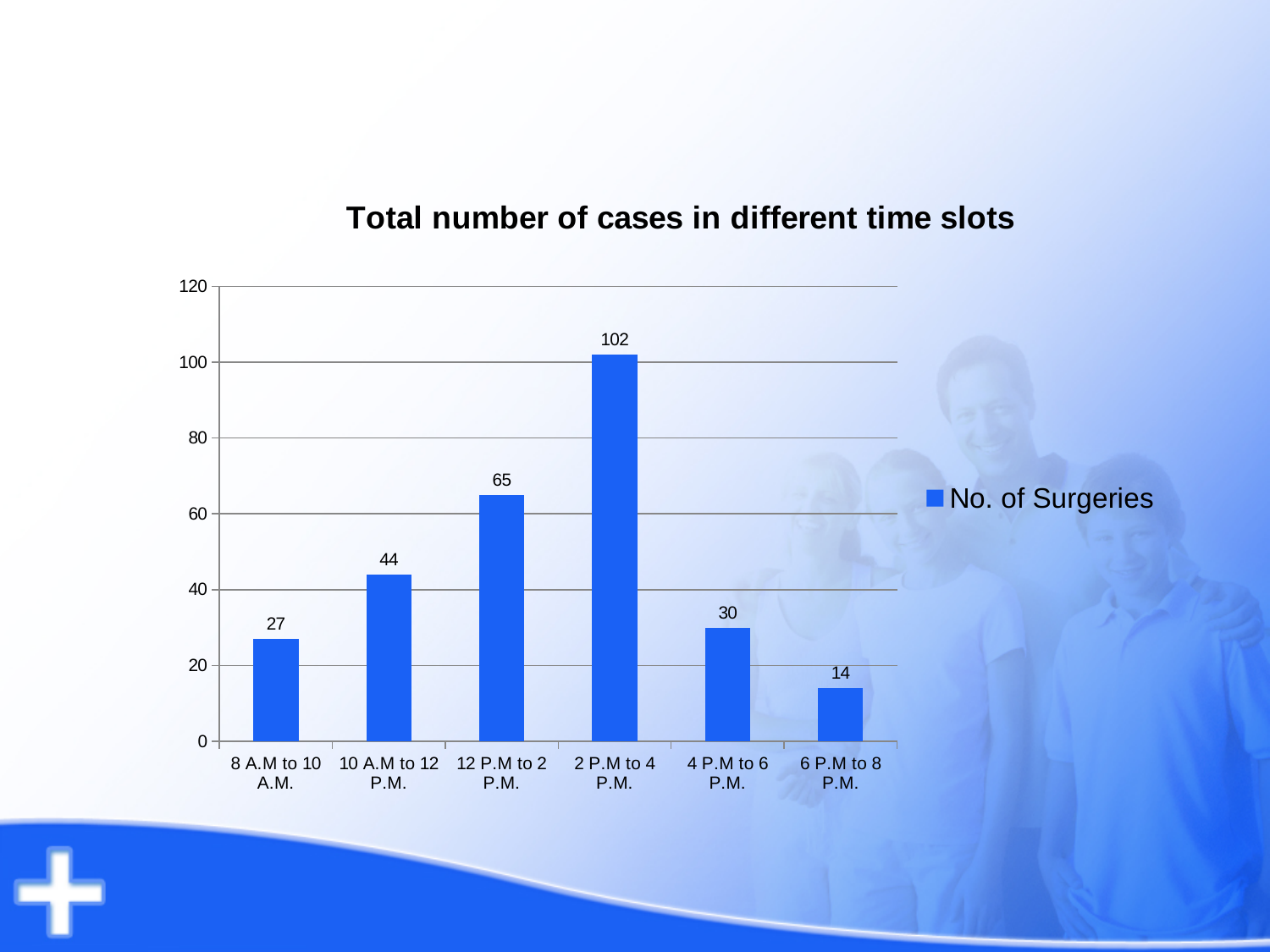
How many series does the legend list? 1 What is the number of surgeries in the 2 P.M to 4 P.M. time slot? 102 Which time slot has the lowest number of surgeries? 6 P.M to 8 P.M. What is the number of surgeries in the 8 A.M to 10 A.M. time slot? 27 Which time slot has more surgeries, 10 A.M to 12 P.M. or 4 P.M to 6 P.M.? 10 A.M to 12 P.M. What is the number of surgeries in the 6 P.M to 8 P.M. time slot? 14 Which time slot has the highest number of surgeries? 2 P.M to 4 P.M. What is the difference in the number of surgeries between the 2 P.M to 4 P.M. slot and the 12 P.M to 2 P.M. slot? 37 Is the value for 12 P.M to 2 P.M. greater or less than 60? greater What kind of chart is shown on the slide? Bar chart What is the title of the chart? Total number of cases in different time slots How many time slots are shown on the chart? 6